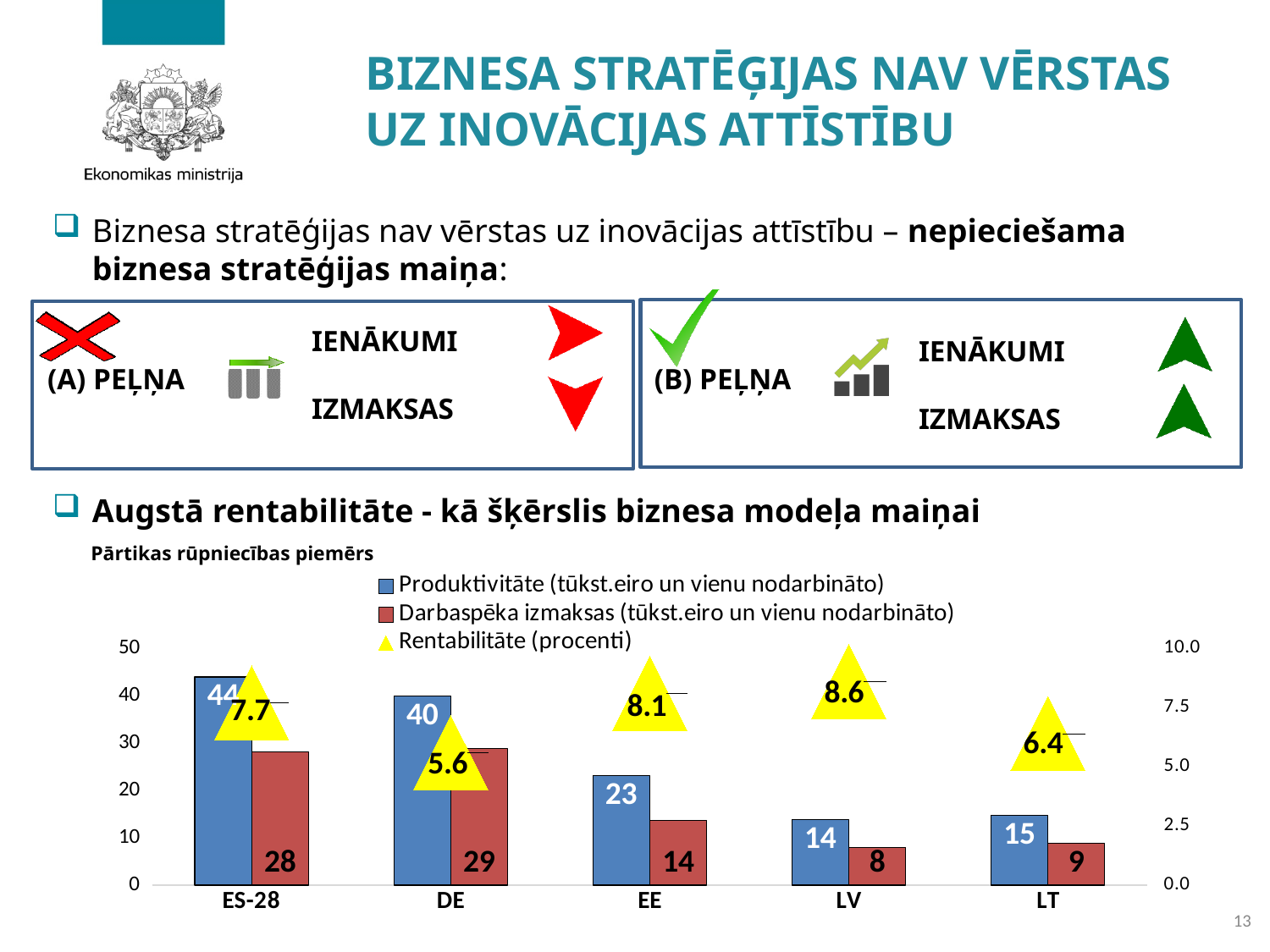
What is the Produktivitāte value for DE? 40 What kind of chart is this? combination bar and line chart How many categories are shown on the x axis? 5 What is the Darbaspēka izmaksas value for LV? 8 What is the difference between the Produktivitāte and Darbaspēka izmaksas values for EE? 9 Which is larger: the Rentabilitāte value for LV or for LT? LV Which category has the lowest Rentabilitāte value? DE Which is larger: the Darbaspēka izmaksas value for ES-28 or for DE? DE What is the Rentabilitāte value for EE? 8.1 How many series does the legend list? 3 What is the subtitle printed above the chart? Pārtikas rūpniecības piemērs Which category has the highest Produktivitāte value? ES-28